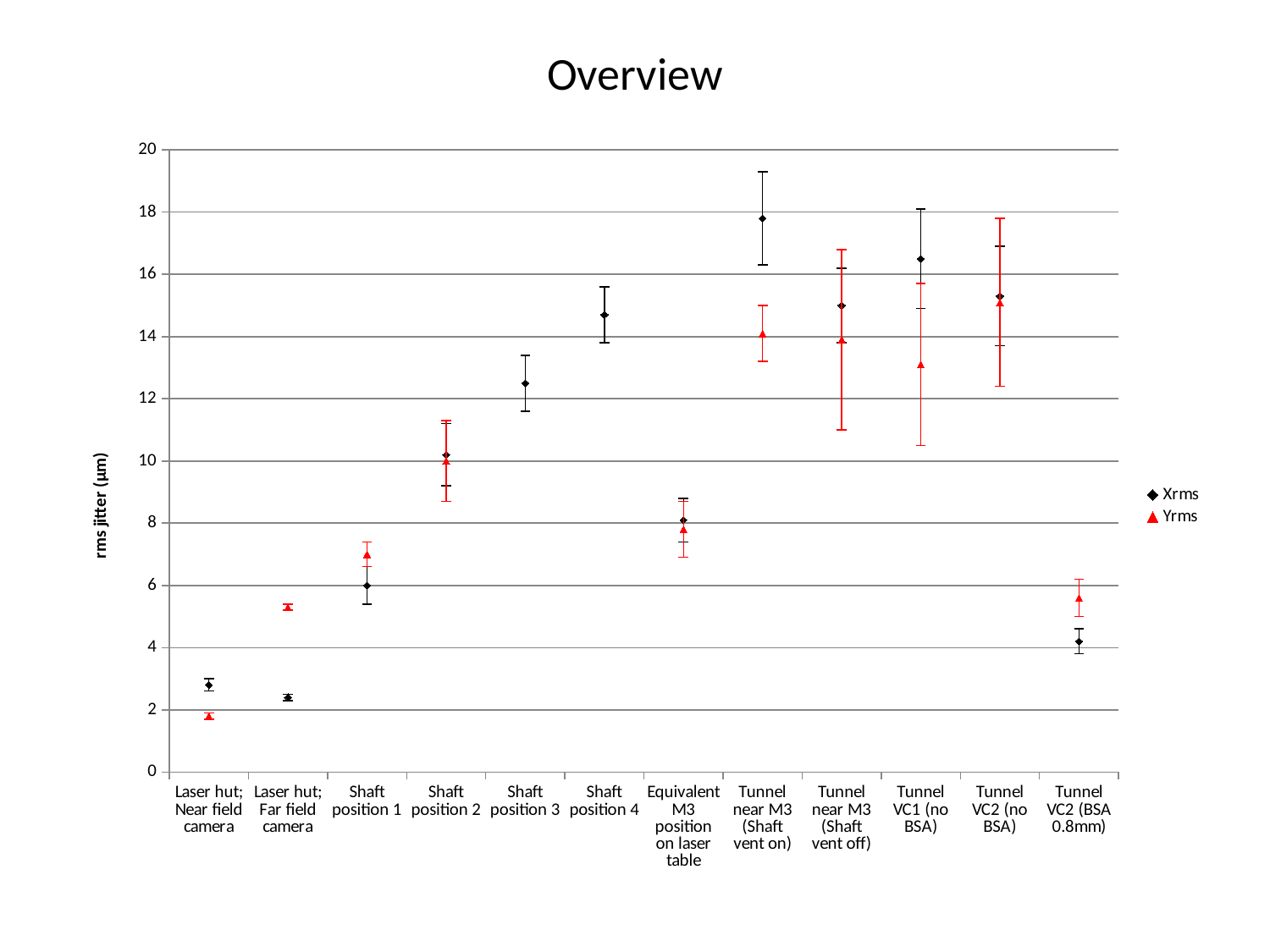
What is the label on the y axis of the chart? rms jitter (µm) Is the Xrms value for Shaft position 4 greater or less than 14? greater How many series does the chart legend list? 2 What is the title of the chart? Overview For Laser hut; Far field camera, which is larger, Xrms or Yrms? Yrms For Tunnel VC1 (no BSA), which is larger, Xrms or Yrms? Xrms Do the Xrms values rise or fall from Shaft position 1 to Shaft position 4? rise Which category has the lowest Yrms value? Laser hut; Near field camera Is the Xrms value for Tunnel near M3 (Shaft vent on) greater or less than 16? greater How many categories are shown on the x axis of the chart? 12 Is the Xrms value for Laser hut; Far field camera greater or less than 4? less Which category has the highest Xrms value? Tunnel near M3 (Shaft vent on)